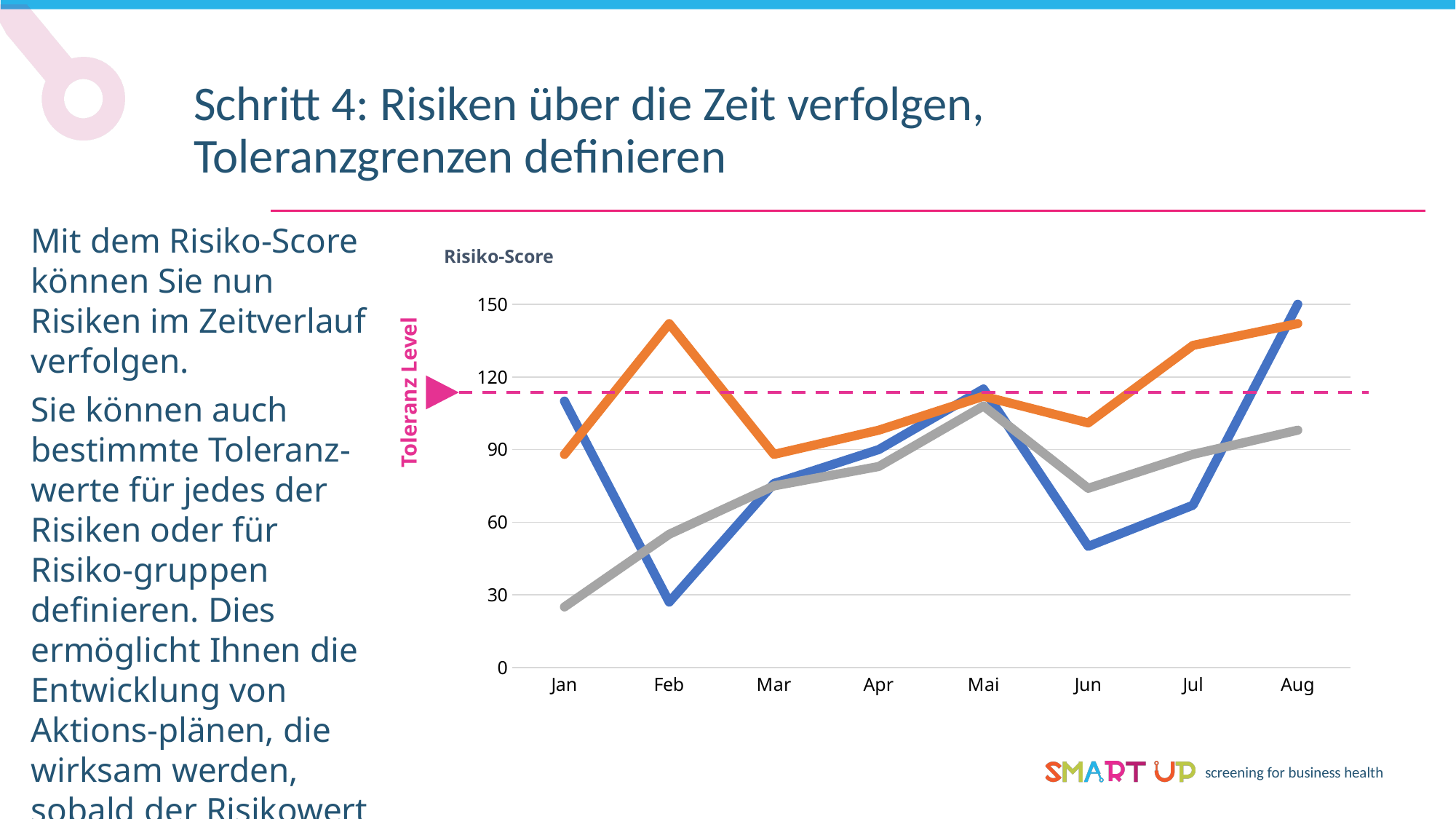
In which month does the blue line reach its highest value? Aug Is the value of the blue line in Aug greater or less than 120? greater In which month does the blue line reach its lowest value? Feb In Feb, which line has the larger value, the orange line or the blue line? orange line What kind of chart is shown on the slide? line chart What is the title of the chart? Risiko-Score How many lines (series) are plotted in the Risiko-Score chart, not counting the dashed tolerance line? 3 Is the value of the blue line in Jun greater or less than 60? less Is the value of the orange line in Feb greater or less than 120? greater How many months are shown on the x axis of the Risiko-Score chart? 8 What label is given to the dashed horizontal line in the chart? Toleranz Level